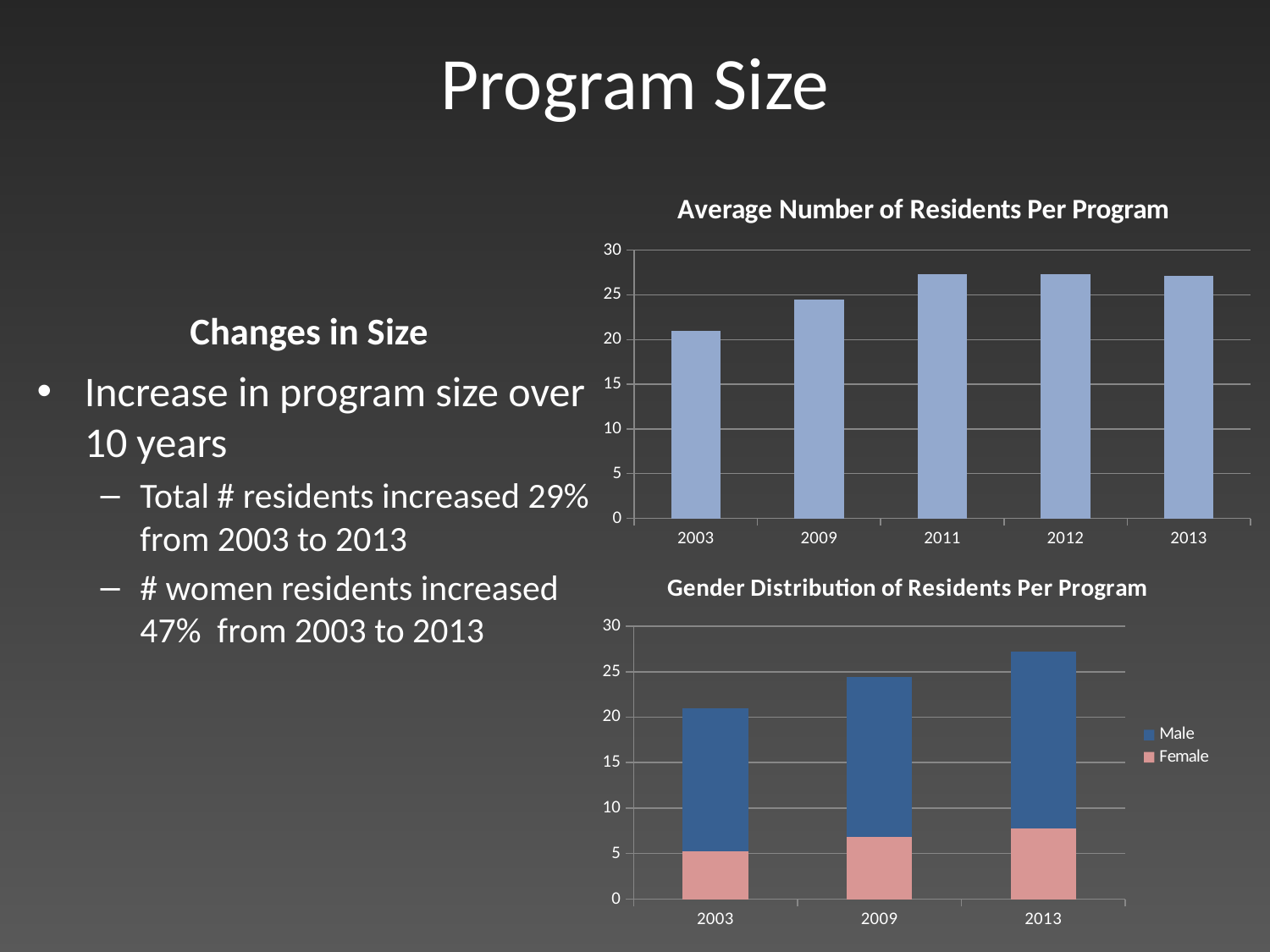
In the 'Average Number of Residents Per Program' chart, is the value for 2003 greater or less than 25? less In the 'Average Number of Residents Per Program' chart, which year has the lowest value? 2003 In the 'Average Number of Residents Per Program' chart, which is larger, the value for 2003 or the value for 2009? 2009 How many years are shown on the x axis of the 'Gender Distribution of Residents Per Program' chart? 3 How many years are shown on the x axis of the 'Average Number of Residents Per Program' chart? 5 What kind of chart is the 'Average Number of Residents Per Program' chart? bar chart How many series does the legend of the 'Gender Distribution of Residents Per Program' chart list? 2 In the 'Average Number of Residents Per Program' chart, is the value for 2011 greater or less than 25? greater In the 'Gender Distribution of Residents Per Program' chart, is the Female value for 2013 greater or less than 10? less In the 'Average Number of Residents Per Program' chart, do the values generally rise or fall from 2003 to 2013? rise What are the two series named in the legend of the 'Gender Distribution of Residents Per Program' chart? Male and Female In the 'Gender Distribution of Residents Per Program' chart, which series has the larger value in 2013, Male or Female? Male